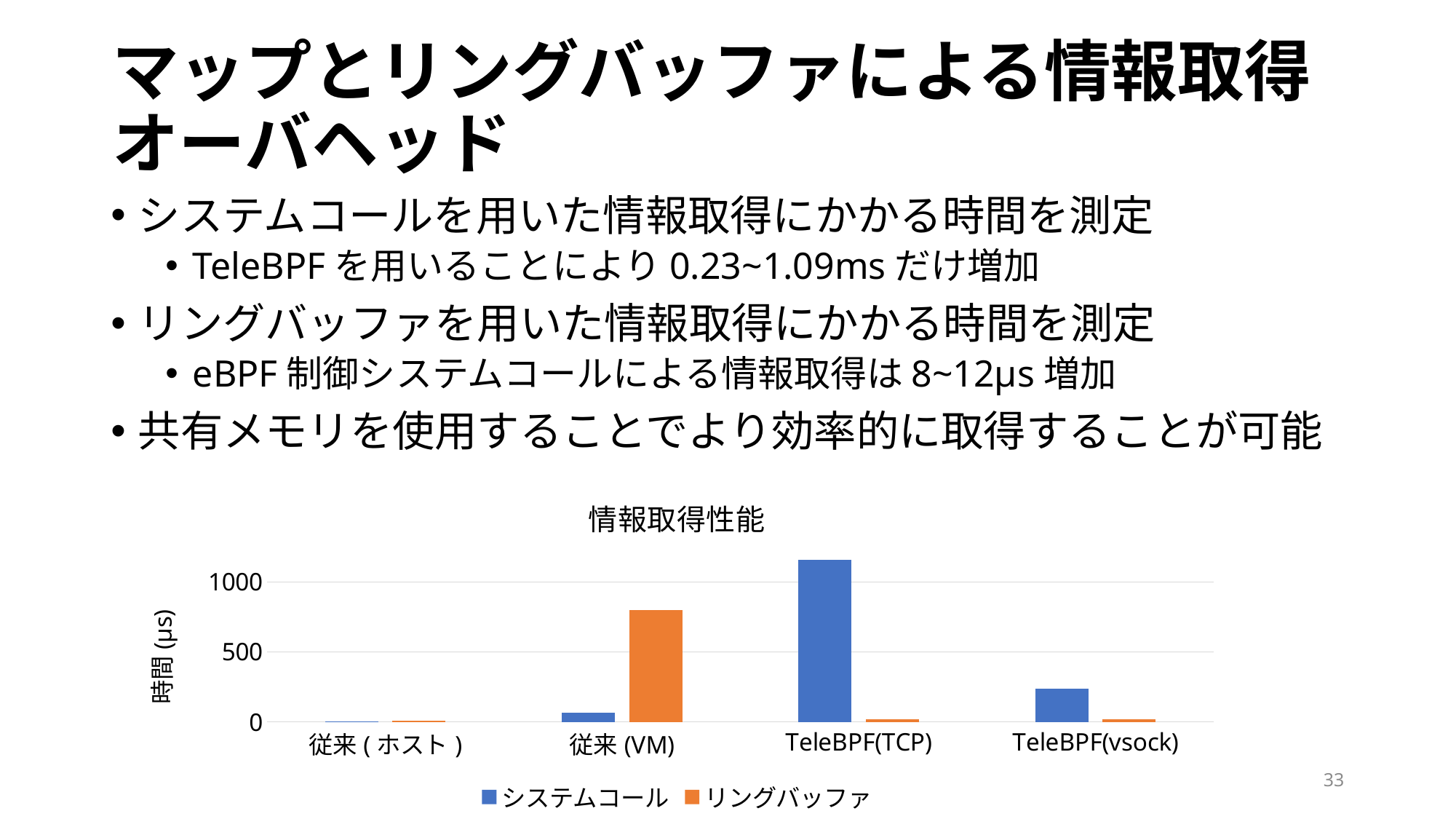
How many series does the chart's legend list? 2 What kind of chart is shown on the slide? bar chart Is the リングバッファ value for 従来 (VM) greater or less than 500? greater How many categories are shown on the x axis of the chart? 4 Is the システムコール value for TeleBPF(vsock) greater or less than 500? less What is the title of the chart? 情報取得性能 Is the システムコール value for TeleBPF(TCP) greater or less than 1000? greater Which category has the highest value for the システムコール series? TeleBPF(TCP) Which category has the highest value for the リングバッファ series? 従来 (VM) Which category has the lowest value for the システムコール series? 従来 ( ホスト ) For TeleBPF(TCP), which series has the larger value, システムコール or リングバッファ? システムコール For 従来 (VM), which series has the larger value, システムコール or リングバッファ? リングバッファ